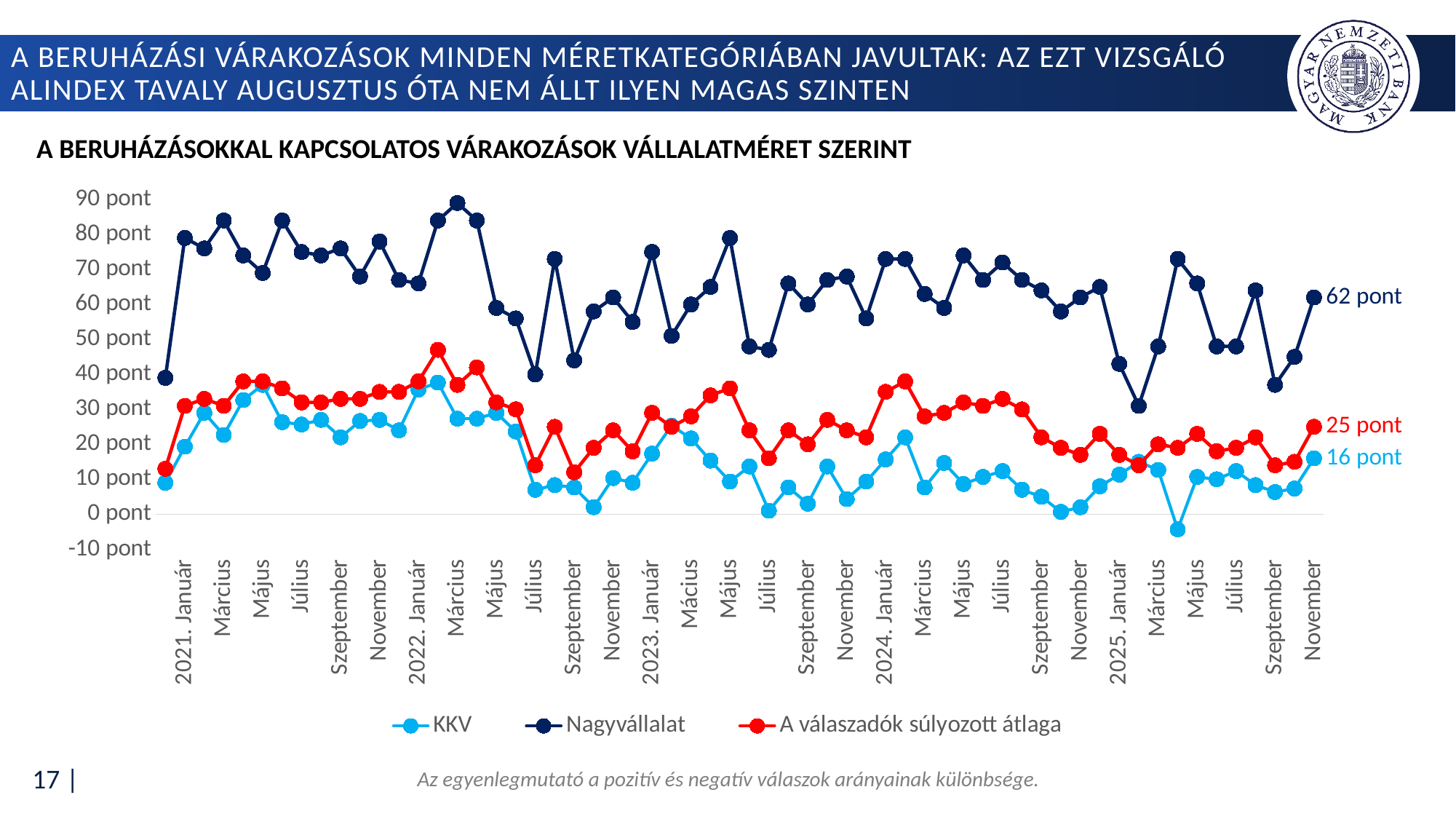
Which series has the highest value at the last point (November 2025)? Nagyvállalat How many series does the legend list? 3 What kind of chart is shown on the slide? Line chart What is the value for Nagyvállalat at the last point (November 2025)? 62 pont What is the difference between the Nagyvállalat and KKV values at the last point (November 2025)? 46 pont What is the difference between the Nagyvállalat value and A válaszadók súlyozott átlaga at the last point (November 2025)? 37 pont What is the title of the chart? A beruházásokkal kapcsolatos várakozások vállalatméret szerint What is the value for KKV at the last point (November 2025)? 16 pont At the last point (November 2025), which is larger: the KKV value or A válaszadók súlyozott átlaga? A válaszadók súlyozott átlaga Which series has the lowest value at the last point (November 2025)? KKV Is the Nagyvállalat value in March 2022 greater or less than 80 pont? greater What is the value for A válaszadók súlyozott átlaga at the last point (November 2025)? 25 pont